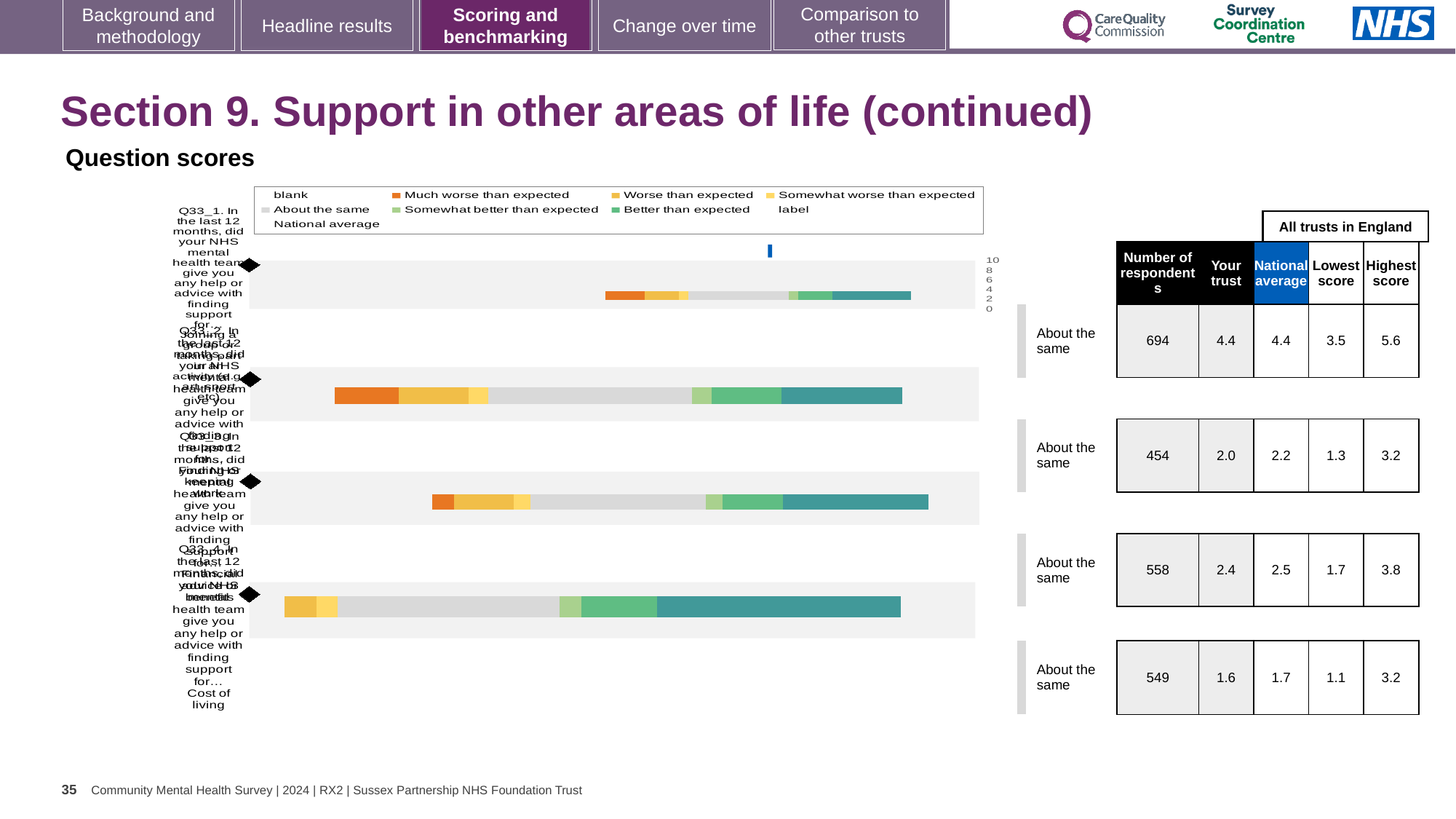
In the table beside the chart, what is the 'Your trust' score for the first row (Q33_1)? 4.4 Which row in the table has the highest 'Your trust' score? The first row (Q33_1), 4.4 Which row in the table has the lowest 'Your trust' score? The fourth row, 1.6 What benchmark text is shown beside each bar in the chart? About the same In the table beside the chart, what is the number of respondents for the first row (Q33_1)? 694 For the second row of the table, which is larger: the 'Your trust' score or the 'National average'? National average How many entries does the chart legend list? 9 How many stacked bars are plotted in the chart? 4 What kind of chart is shown on the slide? Bar chart What colour represents 'Much worse than expected' in the chart legend? Orange In the table beside the chart, what is the 'Lowest score' for the third row? 1.7 For the first row (Q33_1), what is the difference between the highest score and the lowest score? 2.1